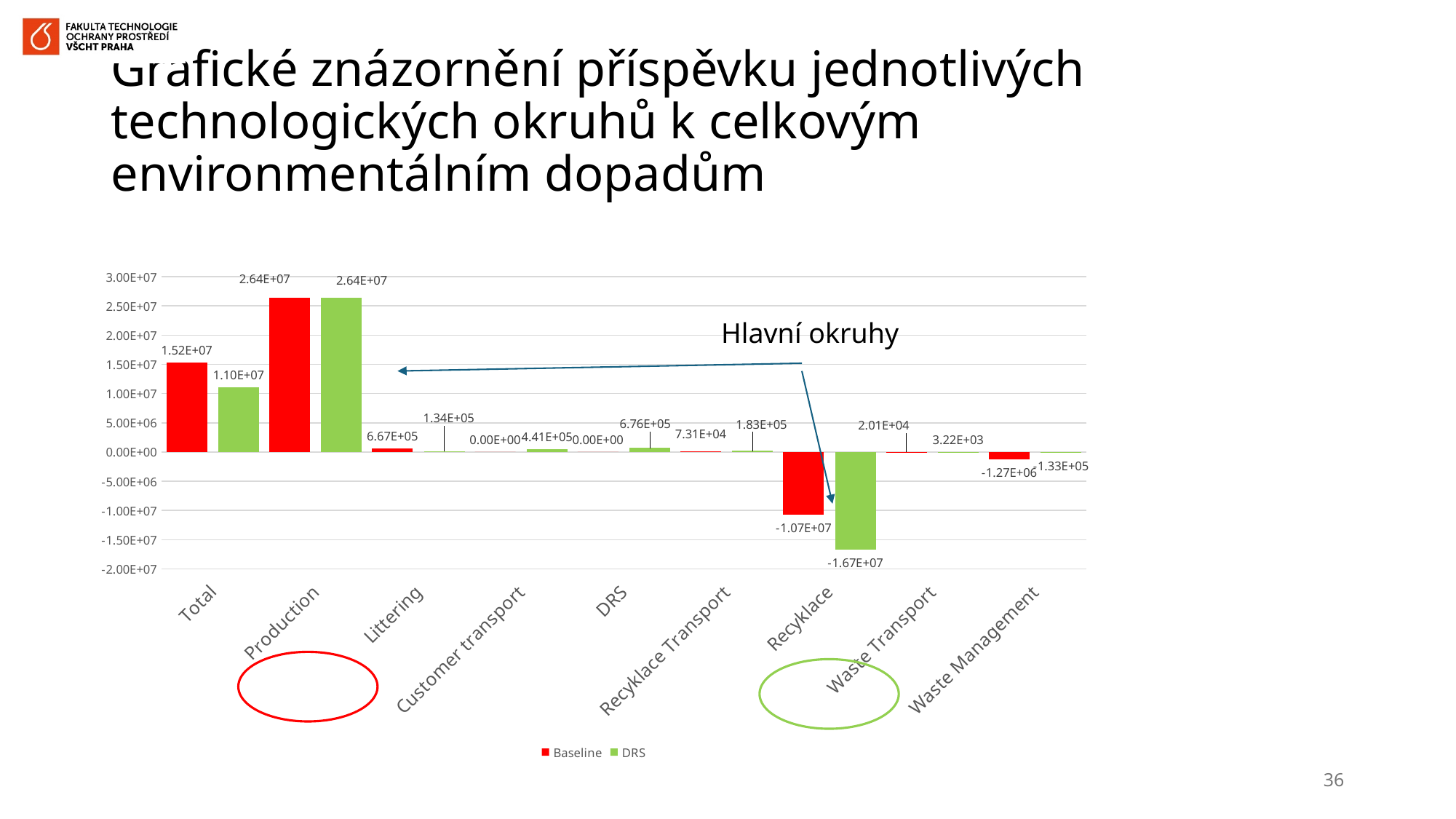
How many series does the legend list? 2 Is the Baseline value for Production greater or less than 2.50E+07? greater Which category has the lowest DRS value? Recyklace What is the DRS value for Total? 1.10E+07 What is the DRS value for Recyklace? -1.67E+07 What kind of chart is shown on the slide? Bar chart Which colour represents the DRS series in the legend? Green For Total, which series has the larger value, Baseline or DRS? Baseline Which category has the highest Baseline value? Production What is the Baseline value for Waste Management? -1.27E+06 How many categories are shown on the x axis? 9 What is the Baseline value for Total? 1.52E+07